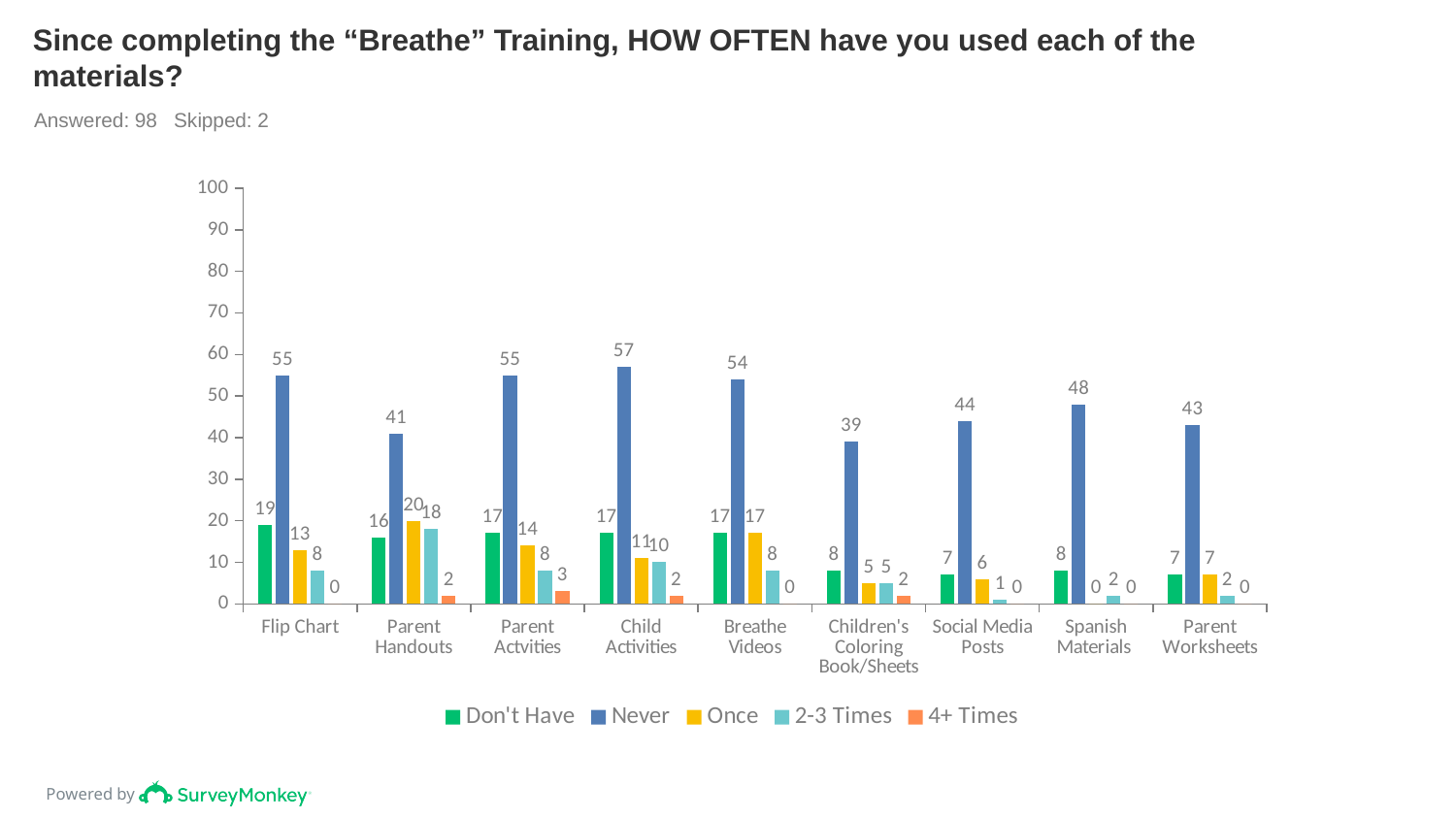
How many series does the legend list? 5 What type of chart is shown on the slide? bar chart What is the 'Once' value for Parent Handouts? 20 What is the difference between the 'Never' values for Flip Chart and Parent Handouts? 14 Which is larger, the 'Don't Have' value for Flip Chart or for Breathe Videos? Flip Chart Which category has the highest 'Never' value? Child Activities Is the 'Never' value for Spanish Materials greater or less than 40? greater What is the 'Never' value for Child Activities? 57 How many material categories are shown on the x axis? 9 Which series is shown in orange in the legend? 4+ Times What is the '2-3 Times' value for Social Media Posts? 1 Which category has the lowest 'Never' value? Children's Coloring Book/Sheets